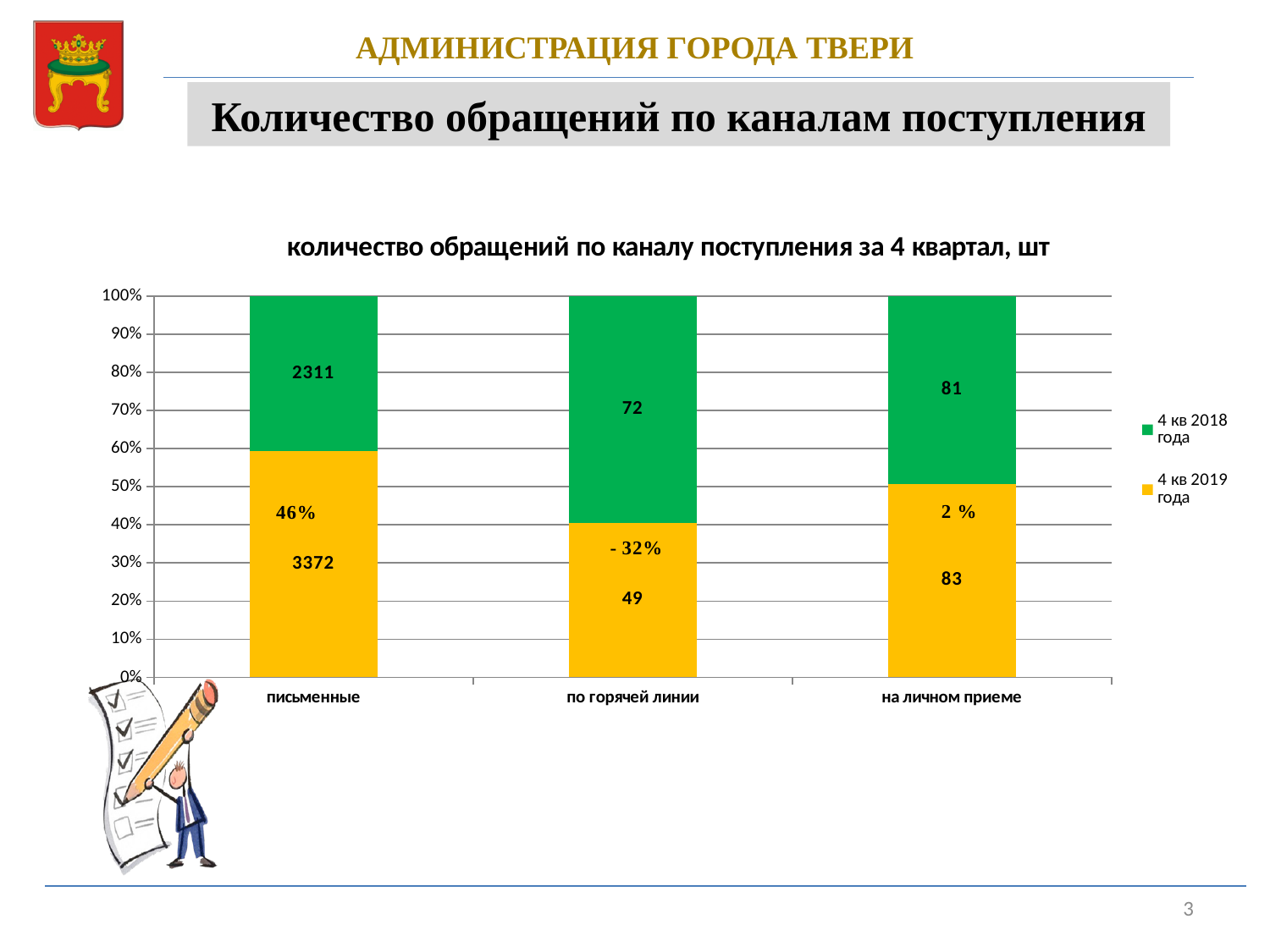
What is the difference between the 4 кв 2019 года and 4 кв 2018 года values for письменные? 1061 Which category has the lowest value in the 4 кв 2018 года series? по горячей линии Which category has the highest value in the 4 кв 2019 года series? письменные How many categories are shown on the x axis? 3 What is the value for письменные in the 4 кв 2018 года series? 2311 What is the difference between the 4 кв 2018 года and 4 кв 2019 года values for по горячей линии? 23 What is the value for по горячей линии in the 4 кв 2018 года series? 72 How many series does the legend list? 2 What is the value for на личном приеме in the 4 кв 2019 года series? 83 What is the value for письменные in the 4 кв 2019 года series? 3372 For по горячей линии, which series has the larger value: 4 кв 2018 года or 4 кв 2019 года? 4 кв 2018 года What kind of chart is shown on the slide? stacked bar chart